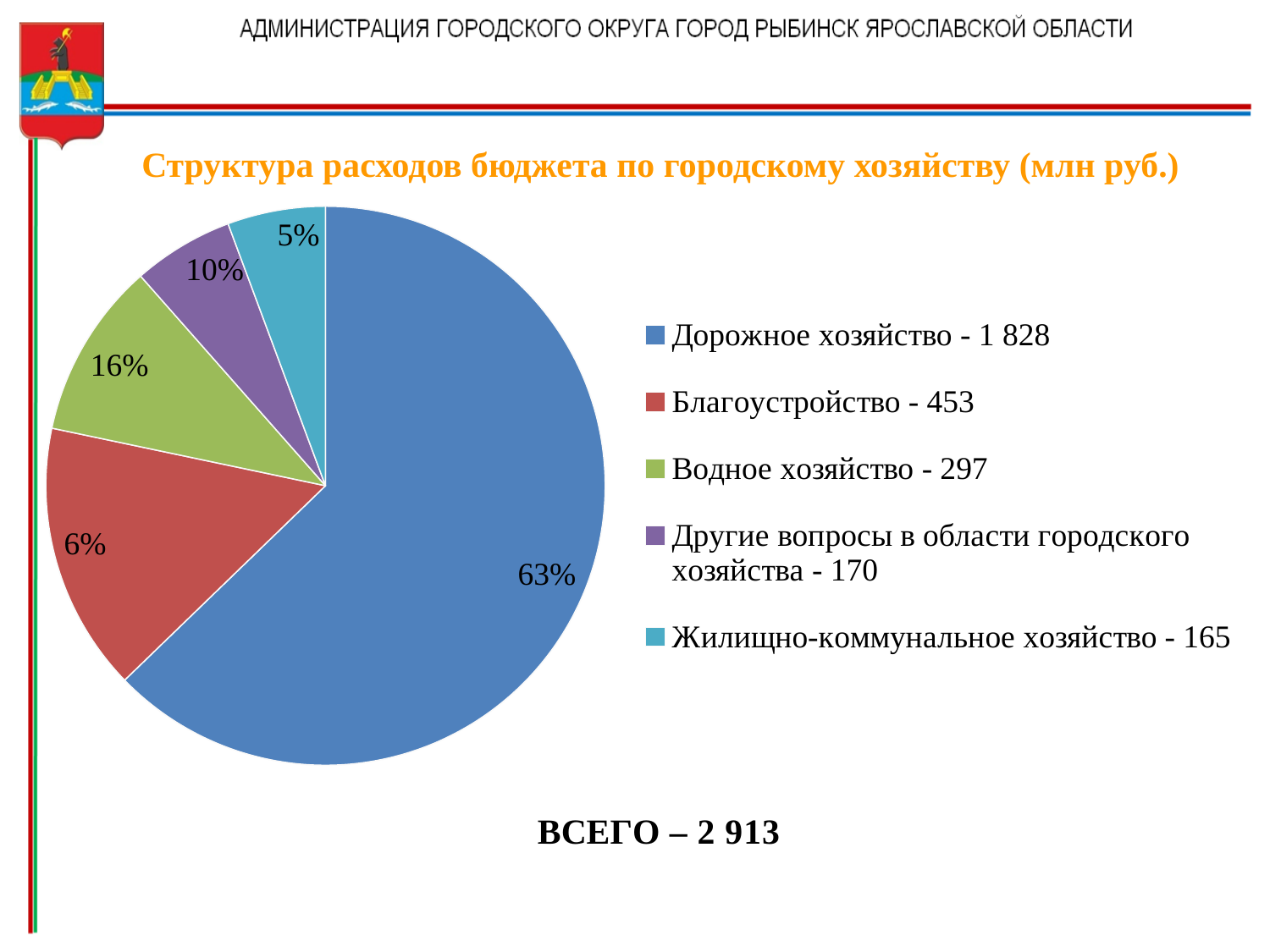
Which category has the smallest value? Жилищно-коммунальное хозяйство What total (ВСЕГО) is stated below the chart? 2 913 What is the value for Благоустройство? 453 What kind of chart is shown on the slide? Pie chart Which category has the largest share of the pie? Дорожное хозяйство What share of the pie does Дорожное хозяйство take? 63% How many categories does the pie chart have? 5 What is the value for Дорожное хозяйство? 1 828 What is the value for Жилищно-коммунальное хозяйство? 165 Which is larger, Водное хозяйство or Другие вопросы в области городского хозяйства? Водное хозяйство What is the value for Водное хозяйство? 297 What is the difference between Дорожное хозяйство and Благоустройство? 1 375